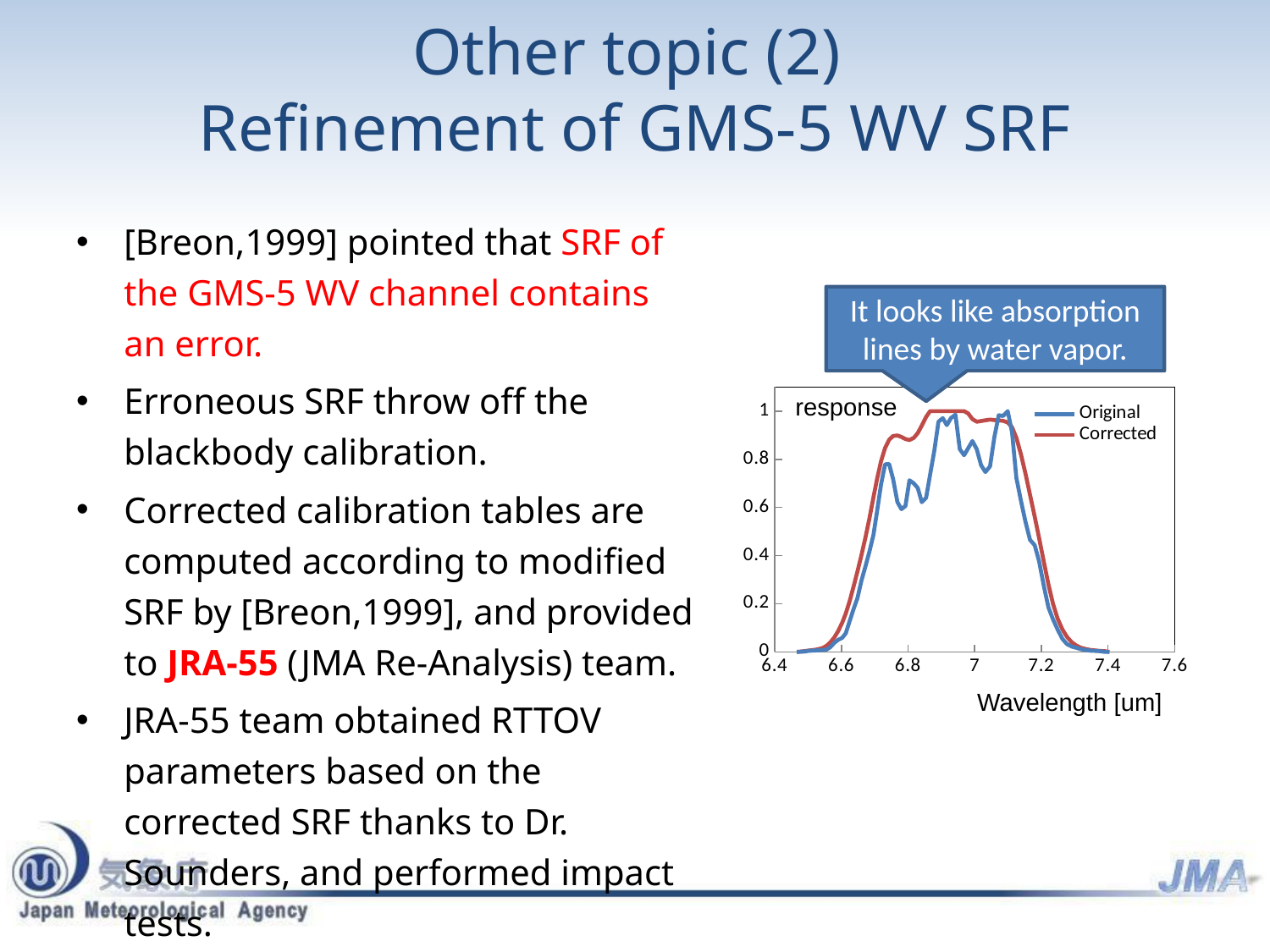
At a wavelength of 7.0 um, which series has the higher response, Original or Corrected? Corrected Is the Original response at a wavelength of 7.4 um greater or less than 0.2? less What is the label of the x axis of the chart? Wavelength [um] Does the Corrected response rise or fall as the wavelength increases from 6.4 um to 6.9 um? rise At a wavelength of 6.8 um, which series has the higher response, Original or Corrected? Corrected Does the Original response rise or fall as the wavelength increases from 7.1 um to 7.4 um? fall Is the Corrected response at a wavelength of 7.0 um greater or less than 0.8? greater What kind of chart is shown on the slide? line chart What are the two series named in the chart's legend? Original and Corrected Is the Corrected response at a wavelength of 6.8 um greater or less than 0.8? greater How many series does the chart's legend list? 2